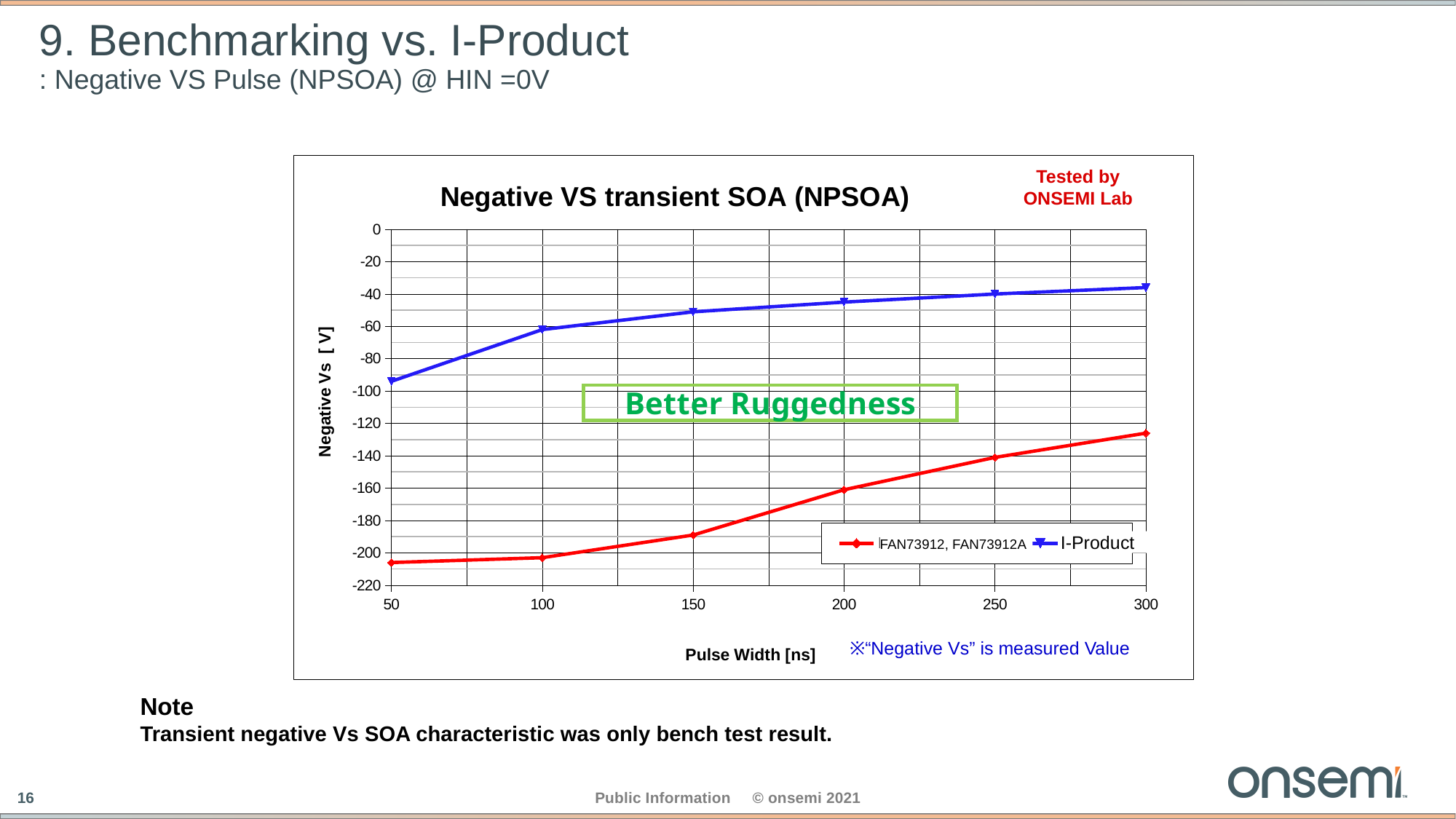
What is the title of the chart? Negative VS transient SOA (NPSOA) What kind of chart is shown on the slide? line chart Is the Negative Vs value for FAN73912, FAN73912A at a pulse width of 300 ns greater or less than -140? greater What is the label of the x axis of the chart? Pulse Width [ns] Is the Negative Vs value for I-Product at a pulse width of 50 ns greater or less than -80? less Do the Negative Vs values for FAN73912, FAN73912A rise or fall as the pulse width increases from 50 ns to 300 ns? rise At a pulse width of 150 ns, which series has the higher (less negative) Negative Vs value: FAN73912, FAN73912A or I-Product? I-Product How many series does the chart legend list? 2 Is the Negative Vs value for FAN73912, FAN73912A at a pulse width of 200 ns greater or less than -140? less How many data points are plotted for the I-Product series? 6